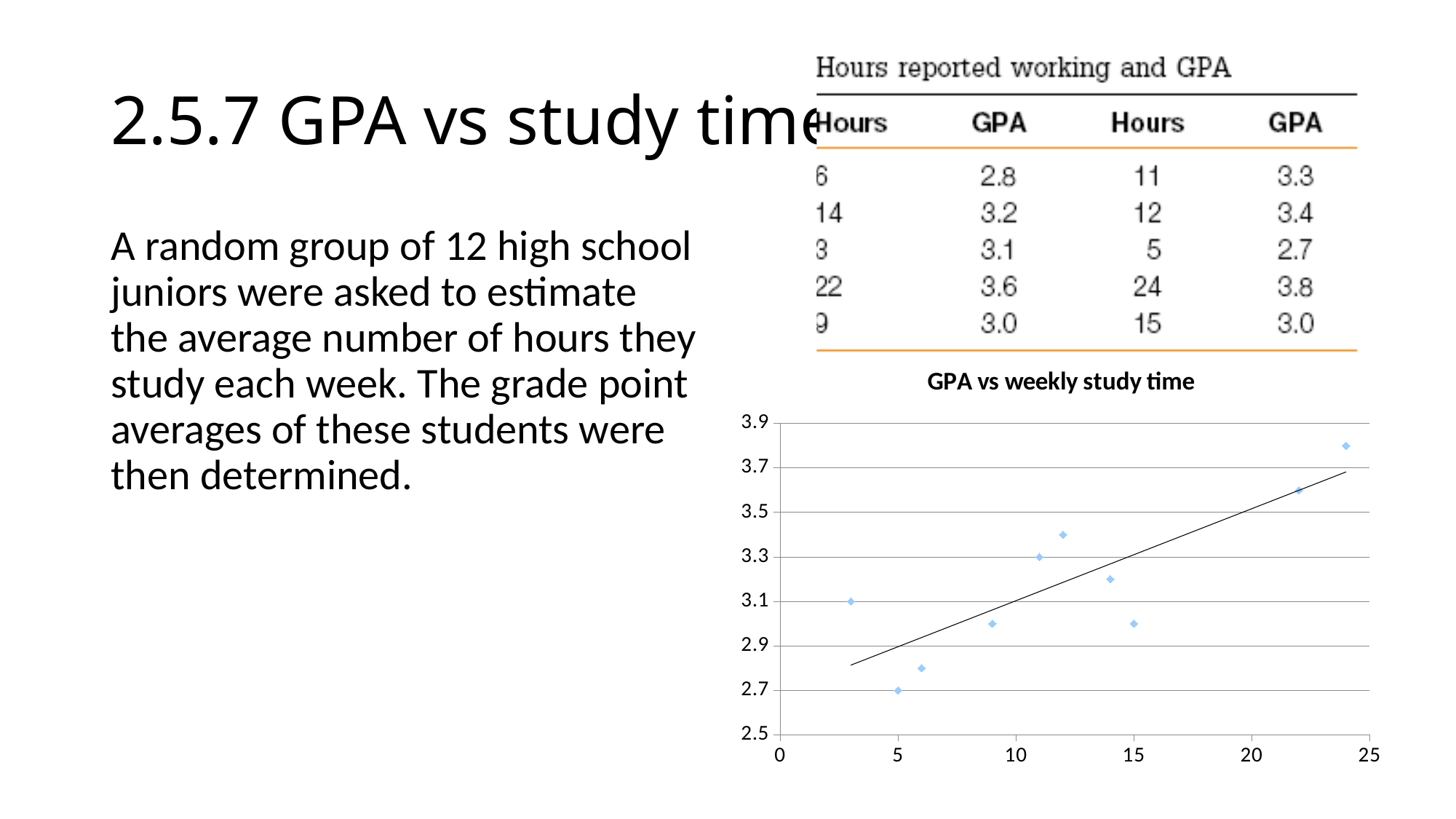
In the 'GPA vs weekly study time' chart, which study time has the lowest GPA? 5 In the 'GPA vs weekly study time' chart, which study time has the highest GPA? 24 In the 'GPA vs weekly study time' chart, which has the higher GPA: 12 hours or 14 hours of study? 12 hours In the 'GPA vs weekly study time' chart, what is the GPA for 3 hours of study? 3.1 In the 'GPA vs weekly study time' chart, what is the GPA for 11 hours of study? 3.3 How many data points are plotted in the 'GPA vs weekly study time' chart? 10 What is the title of the scatter chart on the slide? GPA vs weekly study time In the 'GPA vs weekly study time' chart, what is the GPA for 5 hours of study? 2.7 In the 'GPA vs weekly study time' chart, is the GPA for 24 hours greater or less than 3.7? greater What kind of chart is 'GPA vs weekly study time'? scatter chart In the 'GPA vs weekly study time' chart, is the GPA for 15 hours greater or less than 3.1? less In the 'GPA vs weekly study time' chart, do GPA values generally rise or fall as weekly study hours increase? rise